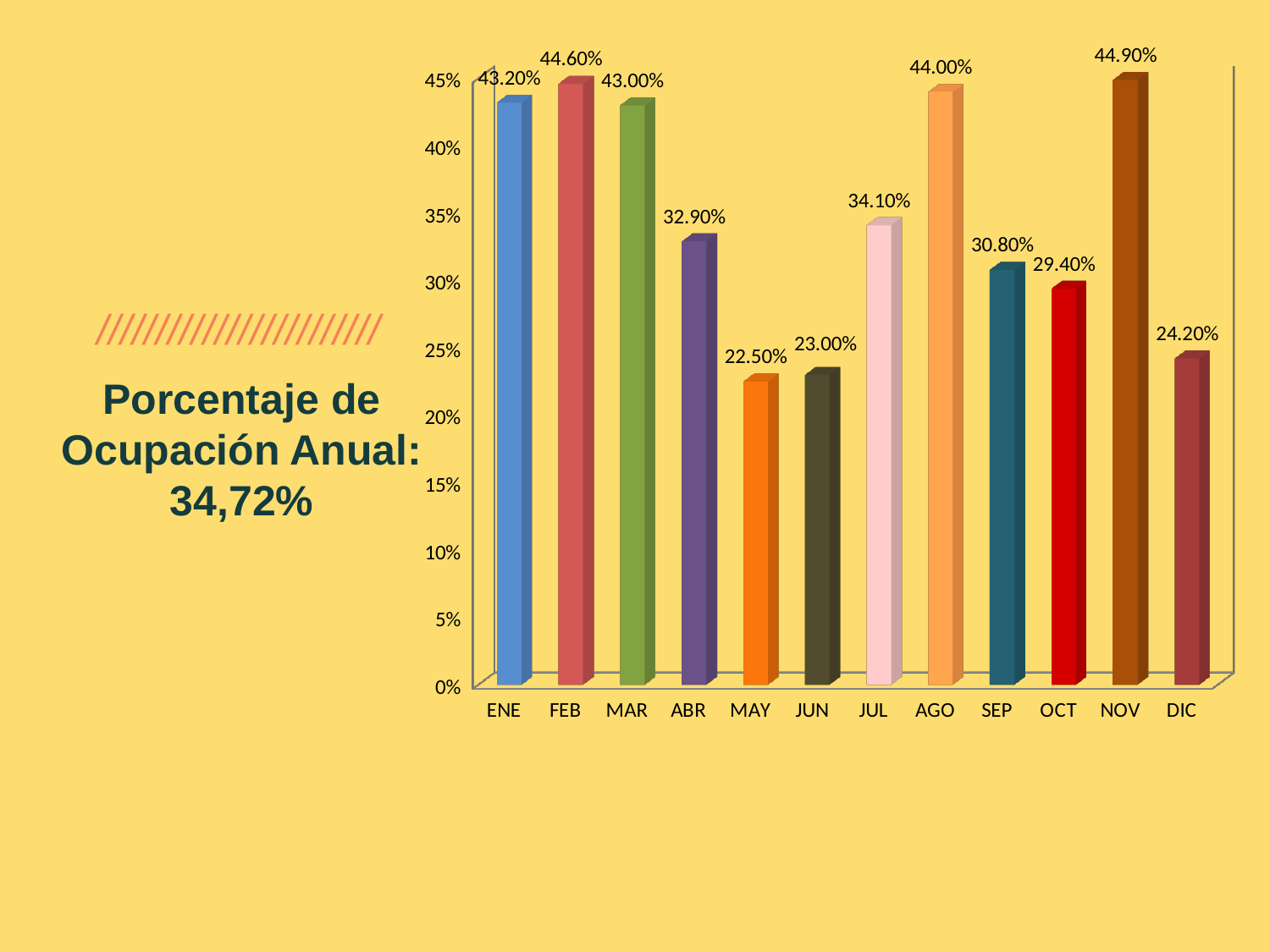
How many months are shown on the x axis? 12 Do the values rise or fall from MAR to MAY? fall Which month has the lowest value? MAY What annual occupancy percentage is stated in the text next to the chart? 34,72% Which is larger, the value for JUL or the value for SEP? JUL Which month has the highest value? NOV Is the value for OCT greater or less than 25%? greater What is the value for DIC? 24.20% What is the value for AGO? 44.00% What is the value for ENE? 43.20% What is the difference between the values for FEB and ABR? 11.70% What kind of chart is shown on the slide? bar chart